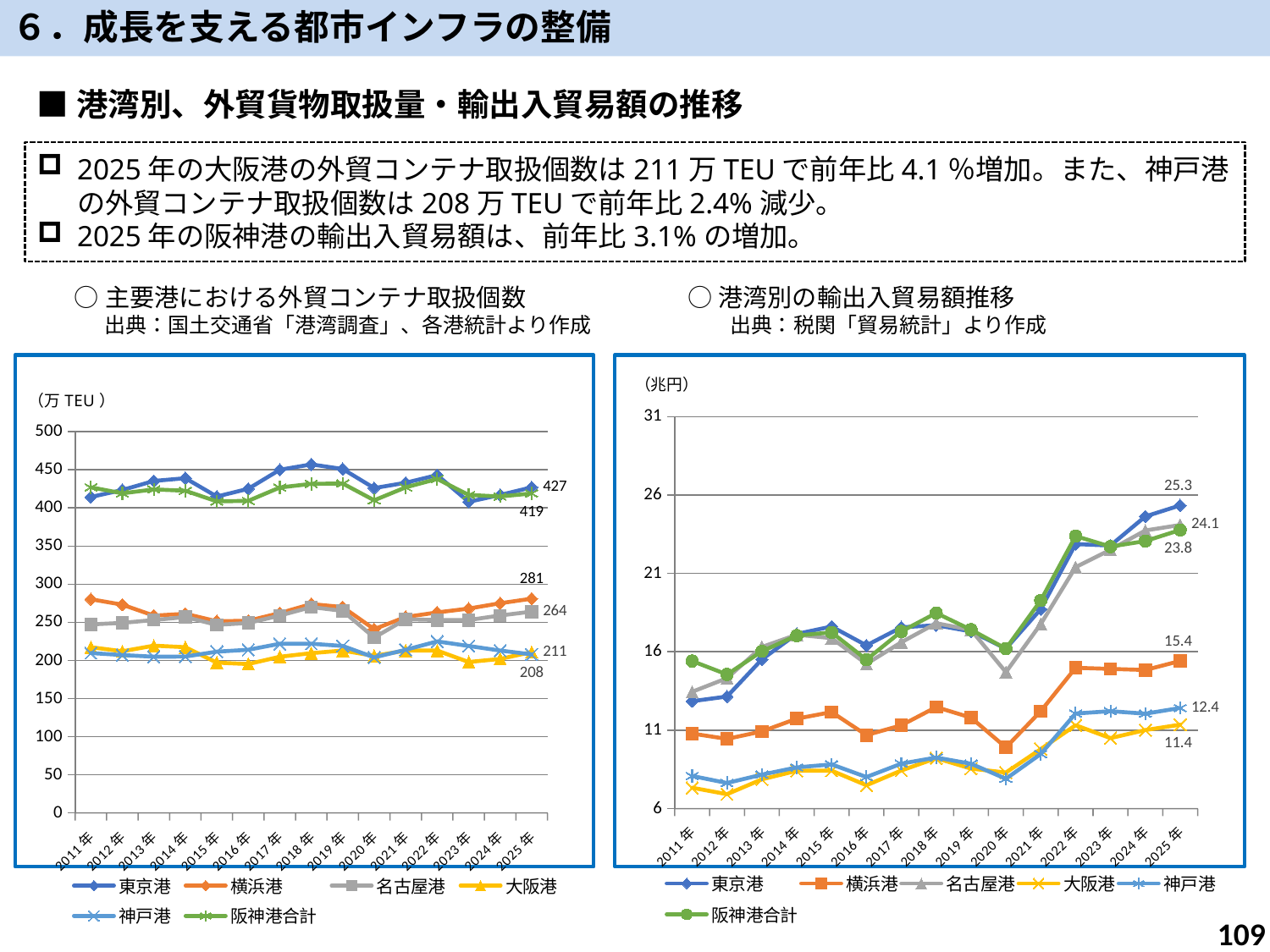
In the left chart (主要港における外貿コンテナ取扱個数), is the value for 名古屋港 in 2020年 greater or less than 250? less What kind of chart is the left chart (主要港における外貿コンテナ取扱個数)? line chart How many series does the legend of the left chart (主要港における外貿コンテナ取扱個数) list? 6 In the right chart (港湾別の輸出入貿易額推移), what is the value for 東京港 in 2025年? 25.3 How many years are plotted along the x axis of the right chart (港湾別の輸出入貿易額推移)? 15 In the left chart (主要港における外貿コンテナ取扱個数), what is the value for 大阪港 in 2025年? 211 In the right chart (港湾別の輸出入貿易額推移), which is larger in 2025年, 神戸港 or 大阪港? 神戸港 In the left chart (主要港における外貿コンテナ取扱個数), what is the difference between 大阪港 and 神戸港 in 2025年? 3 In the right chart (港湾別の輸出入貿易額推移), what is the difference between 東京港 and 名古屋港 in 2025年? 1.2 In the right chart (港湾別の輸出入貿易額推移), which series has the highest value in 2025年? 東京港 In the right chart (港湾別の輸出入貿易額推移), what is the value for 横浜港 in 2025年? 15.4 In the left chart (主要港における外貿コンテナ取扱個数), what is the value for 東京港 in 2025年? 427